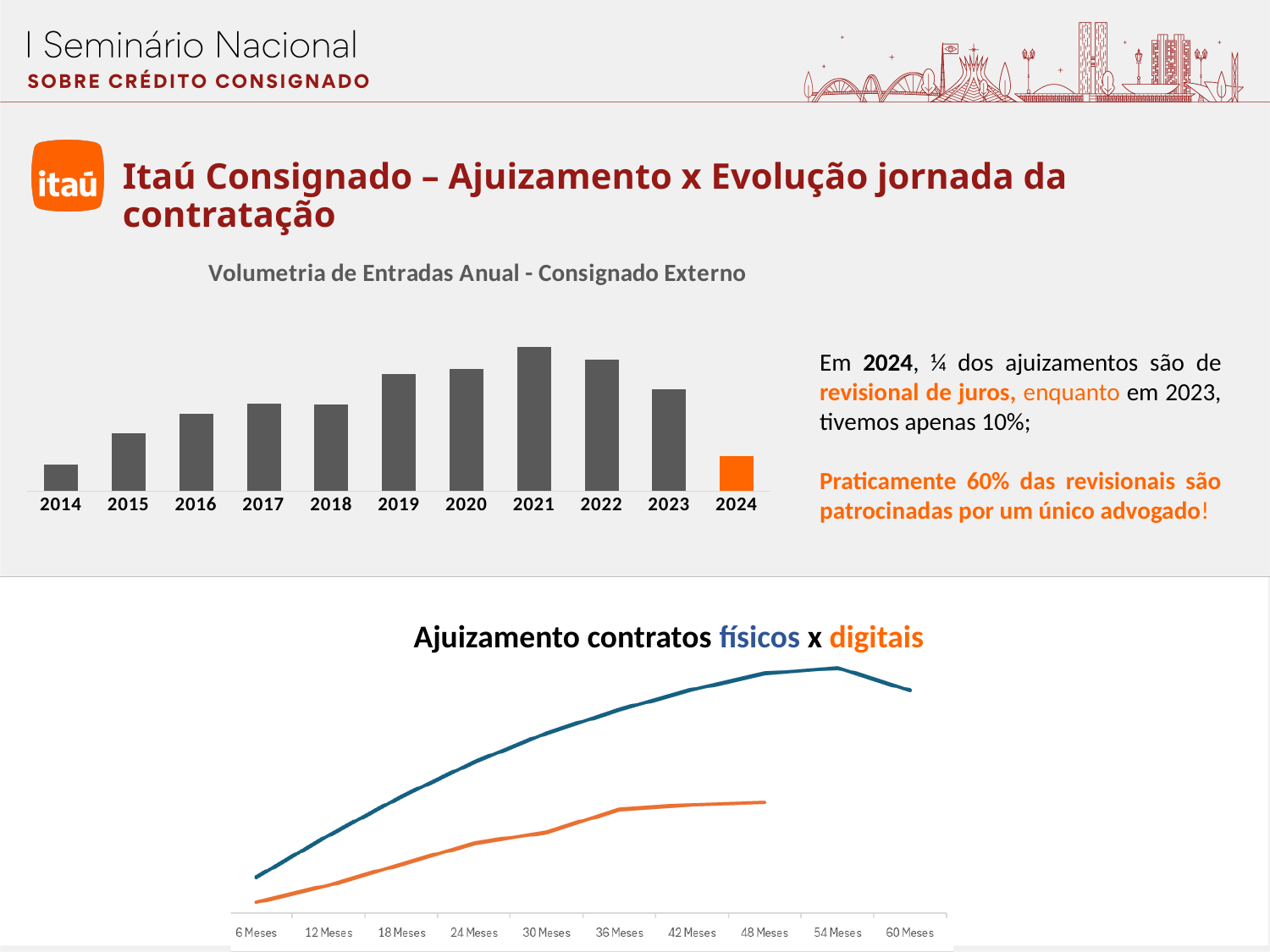
On the chart 'Ajuizamento contratos físicos x digitais', how many series are plotted? 2 On the chart 'Ajuizamento contratos físicos x digitais', what kind of chart is it? line chart On the chart 'Volumetria de Entradas Anual - Consignado Externo', which year's bar is coloured orange? 2024 On the chart 'Volumetria de Entradas Anual - Consignado Externo', which year has the lowest bar? 2014 On the chart 'Ajuizamento contratos físicos x digitais', how many month labels are shown on the x axis? 10 On the chart 'Volumetria de Entradas Anual - Consignado Externo', do the values rise or fall from 2021 to 2024? fall On the chart 'Volumetria de Entradas Anual - Consignado Externo', which is higher, 2022 or 2023? 2022 On the chart 'Ajuizamento contratos físicos x digitais', which series is higher at 36 Meses, físicos or digitais? físicos On the chart 'Volumetria de Entradas Anual - Consignado Externo', how many years are shown on the x axis? 11 On the chart 'Volumetria de Entradas Anual - Consignado Externo', which year has the highest bar? 2021 On the chart 'Volumetria de Entradas Anual - Consignado Externo', what kind of chart is it? bar chart On the chart 'Volumetria de Entradas Anual - Consignado Externo', which is higher, 2018 or 2019? 2019